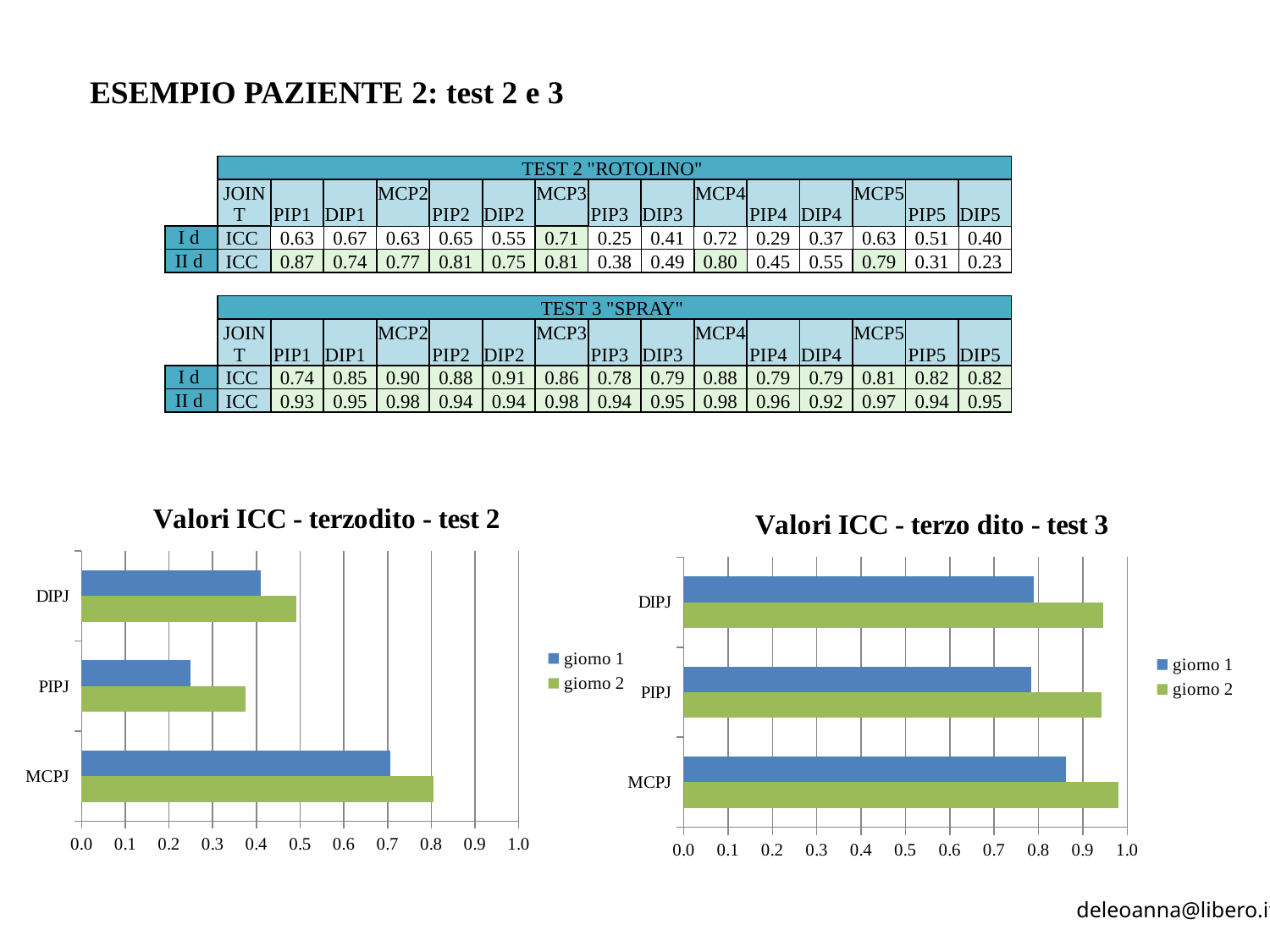
In the chart "Valori ICC - terzodito - test 2", is the giorno 2 value for PIPJ greater or less than 0.5? less In the chart "Valori ICC - terzodito - test 2", which category has the lowest giorno 1 value? PIPJ In the chart "Valori ICC - terzodito - test 2", which is larger: the giorno 1 value for MCPJ or the giorno 2 value for DIPJ? giorno 1 value for MCPJ In the chart "Valori ICC - terzodito - test 2", which category has the highest giorno 2 value? MCPJ What are the two legend entries of the chart "Valori ICC - terzodito - test 2"? giorno 1, giorno 2 In the chart "Valori ICC - terzo dito - test 3", which is larger for DIPJ: giorno 1 or giorno 2? giorno 2 What kind of chart is "Valori ICC - terzodito - test 2"? bar chart In the chart "Valori ICC - terzo dito - test 3", is the giorno 2 value for MCPJ greater or less than 0.9? greater How many series does the legend of the chart "Valori ICC - terzo dito - test 3" list? 2 How many categories are shown on the y axis of the chart "Valori ICC - terzodito - test 2"? 3 In the chart "Valori ICC - terzodito - test 2", is the giorno 1 value for MCPJ greater or less than 0.6? greater In the chart "Valori ICC - terzo dito - test 3", which category has the highest giorno 1 value? MCPJ